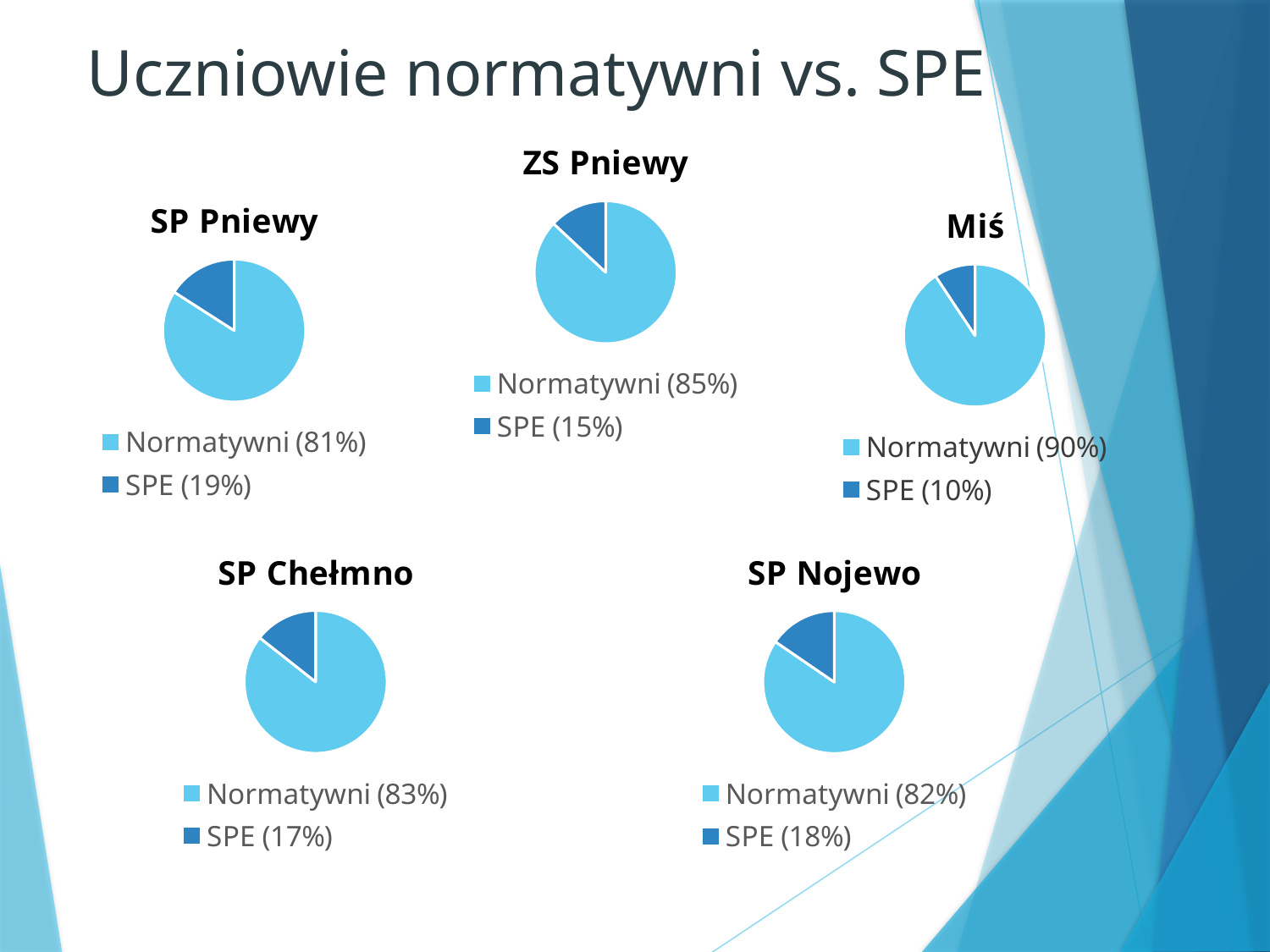
In the SP Pniewy chart, what share of students is SPE? 19% Which of the five charts shows the lowest SPE share? Miś In the ZS Pniewy chart, what share of students is Normatywni? 85% Which of the five charts shows the highest SPE share? SP Pniewy How many slices does the Miś pie chart have? 2 In the SP Nojewo chart, what share of students is SPE? 18% What kind of chart is the SP Chełmno chart? Pie chart In the Miś chart, what share of students is SPE? 10% In the ZS Pniewy chart, what is the difference between the Normatywni and SPE shares? 70% In the SP Chełmno chart, what share of students is Normatywni? 83% How many entries does the legend of the SP Nojewo chart list? 2 In the SP Pniewy chart, which slice is larger, Normatywni or SPE? Normatywni